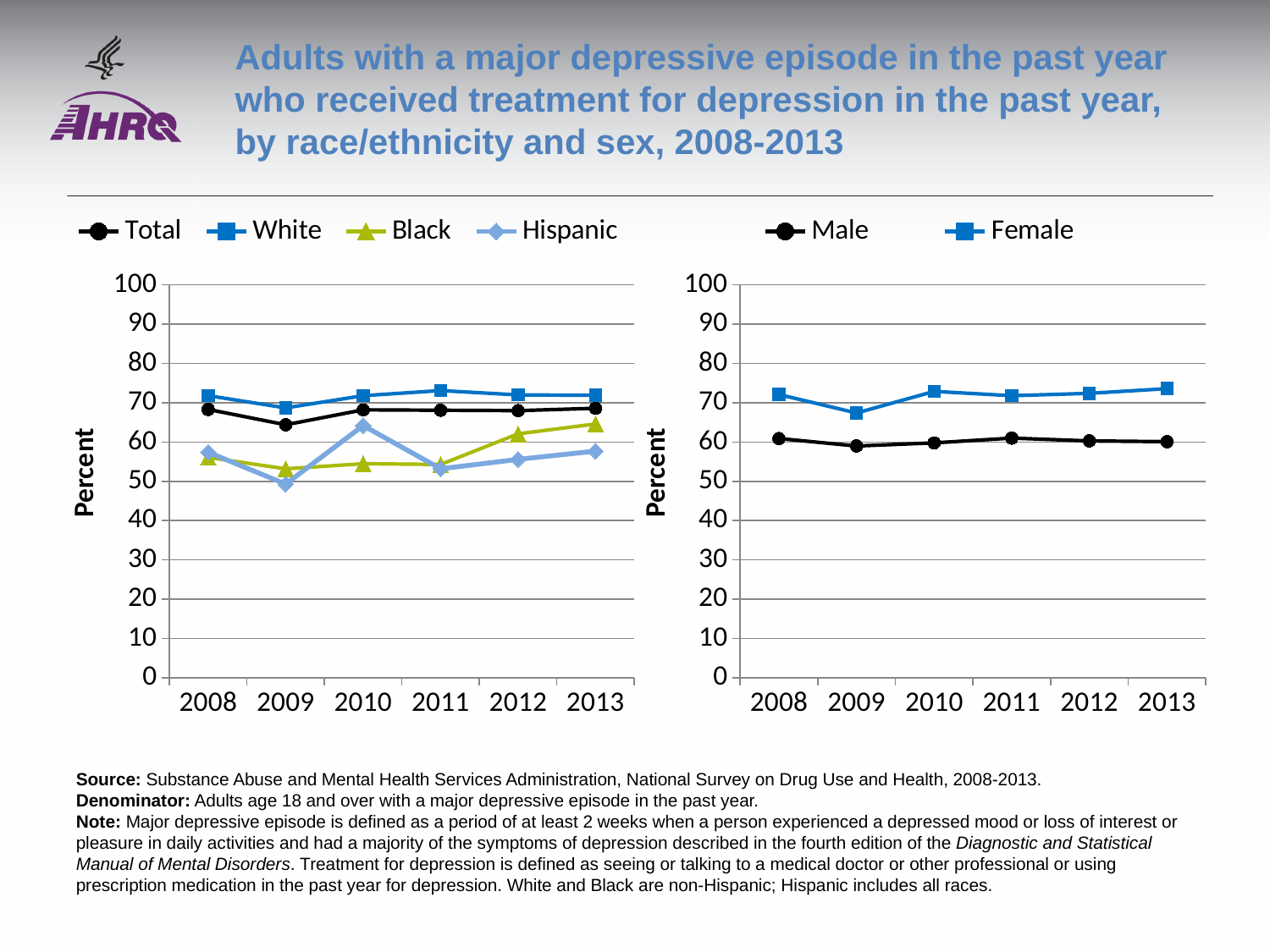
In the left chart (by race/ethnicity), is the value for Hispanic in 2009 greater or less than 60? less In the right chart (by sex), is the value for Female in 2009 greater or less than 70? less How many series does the legend of the left chart (by race/ethnicity) list? 4 What kind of chart is the left chart (by race/ethnicity)? Line chart How many series does the legend of the right chart (by sex) list? 2 How many years are shown on the x axis of the right chart (by sex)? 6 In the left chart (by race/ethnicity), which is larger in 2010, Black or Hispanic? Hispanic In the right chart (by sex), which is larger in 2013, Male or Female? Female In the left chart (by race/ethnicity), is the value for White in 2008 greater or less than 70? greater In the left chart (by race/ethnicity), does the value for Black rise or fall from 2011 to 2013? rise In the left chart (by race/ethnicity), which group has the lowest value in 2009? Hispanic In the left chart (by race/ethnicity), which group has the highest value in 2013? White